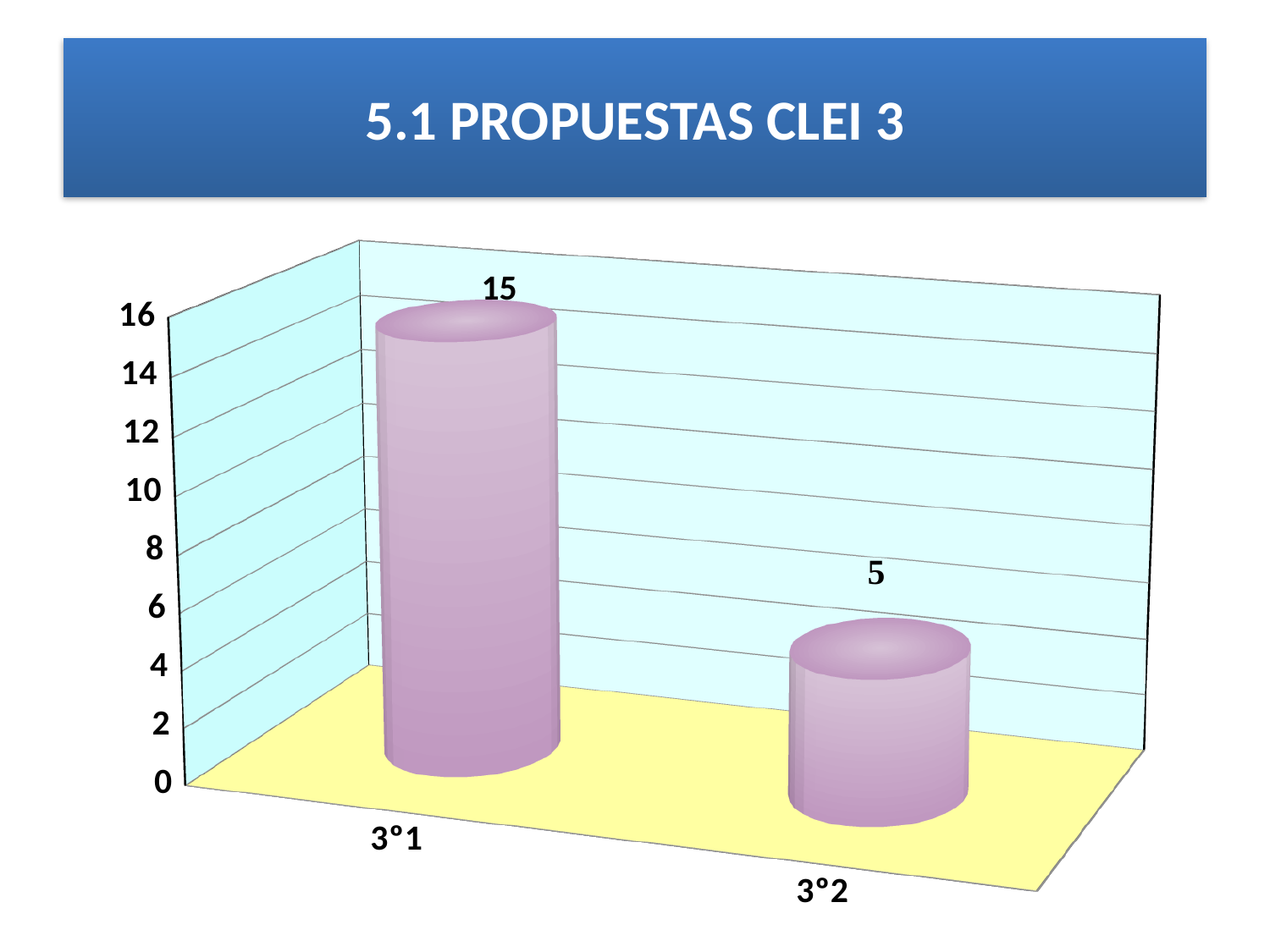
How many categories are shown in the chart? 2 Is the value for 3°1 greater or less than 10? greater Which category has the highest value? 3°1 What is the difference between the values for 3°1 and 3°2? 10 What is the title of the slide? 5.1 PROPUESTAS CLEI 3 What is the value for 3°2? 5 Do the values rise or fall from 3°1 to 3°2? fall Which is larger, the value for 3°1 or the value for 3°2? 3°1 Is the value for 3°2 greater or less than 8? less What is the value for 3°1? 15 Which category has the lowest value? 3°2 What kind of chart is shown on the slide? bar chart